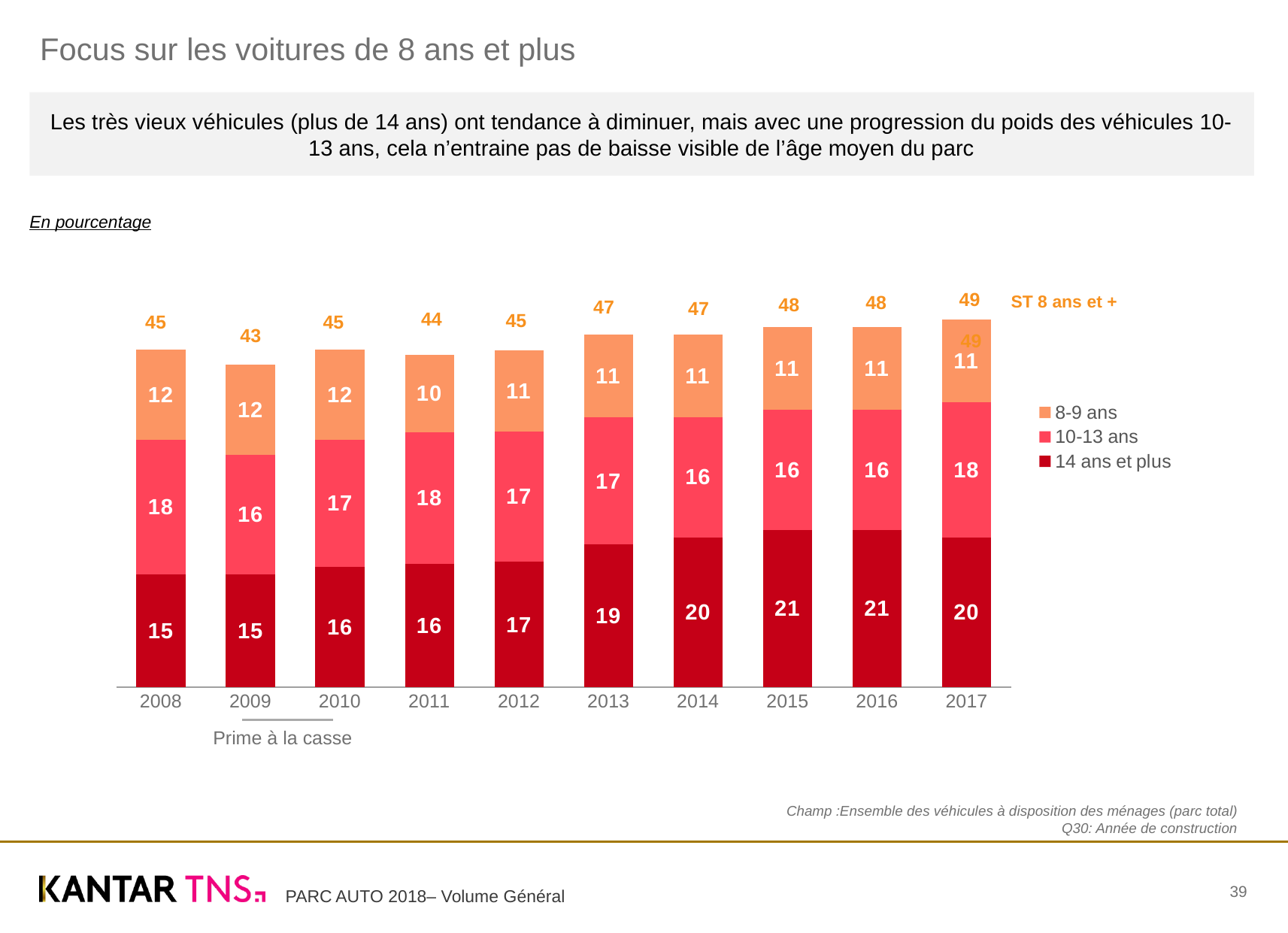
How many years are shown on the x axis? 10 How many series does the legend list? 3 Which year has the highest "ST 8 ans et +" total? 2017 What kind of chart is shown on the slide? Stacked bar chart Does the "14 ans et plus" value rise or fall from 2008 to 2015? Rise What is the value for "10-13 ans" in 2017? 18 What is the value for "14 ans et plus" in 2013? 19 Which is larger, the "10-13 ans" value in 2008 or in 2009? 2008 What is the value for "8-9 ans" in 2011? 10 Which year has the lowest "ST 8 ans et +" total? 2009 What is the "ST 8 ans et +" total shown above the 2009 bar? 43 What is the difference between the "14 ans et plus" values for 2016 and 2008? 6